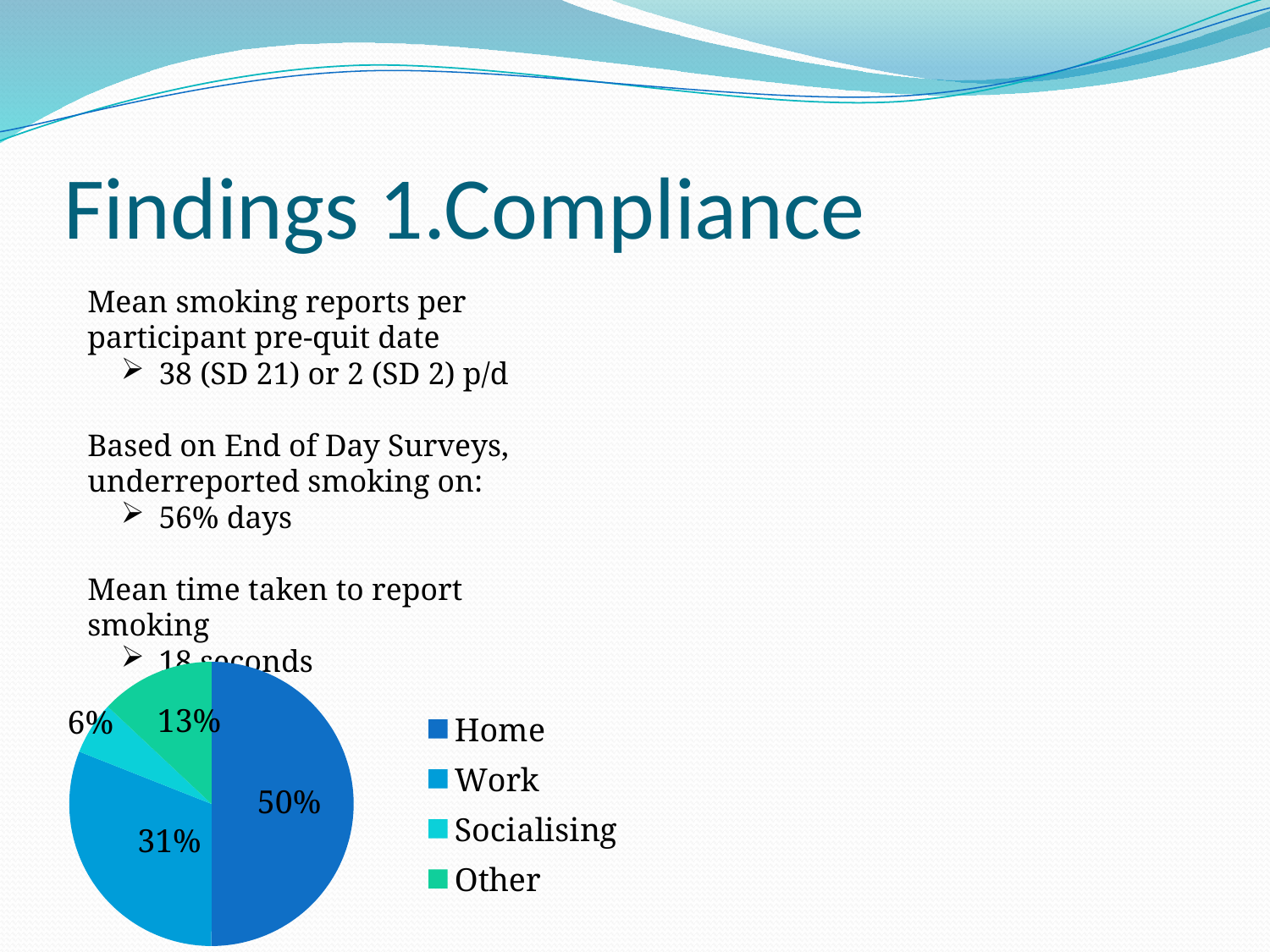
What kind of chart is shown on the slide? pie chart What is the difference in percentage points between the Other and Socialising slices? 7 Which slice is larger, Other or Socialising? Other How many slices does the pie chart have? 4 Which category has the smallest slice of the pie? Socialising What share of the pie does Other account for? 13% What share of the pie does Work account for? 31% How many entries does the legend list? 4 What is the difference in percentage points between the Home and Work slices? 19 Which category has the largest slice of the pie? Home What share of the pie does Home account for? 50%